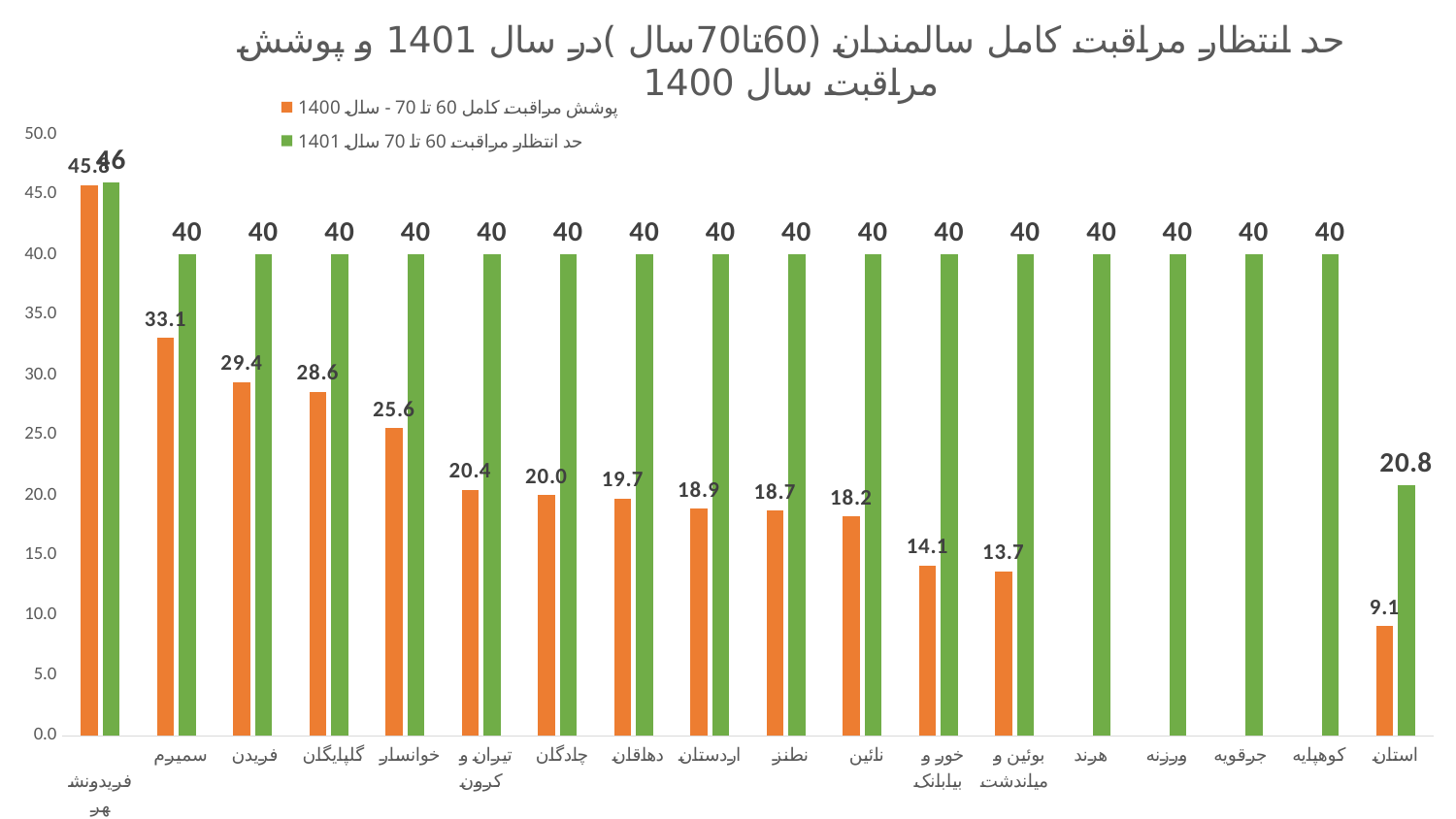
What is the value of the green series (حد انتظار مراقبت 60 تا 70 سال 1401) for استان? 20.8 What is the value of the green series (سال 1401) for فریدونشهر? 46 What is the value of the orange series (پوشش مراقبت کامل 60 تا 70 - سال 1400) for سمیرم? 33.1 How many categories are shown on the x axis? 18 Which category has the highest value in the orange series (سال 1400)? فریدونشهر What is the value of the orange series (سال 1400) for خور و بیابانک? 14.1 How many series does the legend list? 2 What kind of chart is shown on the slide? bar chart What is the difference between the orange (سال 1400) values for فریدن and گلپایگان? 0.8 Which category has the lowest value in the green series (سال 1401)? استان Is the orange (سال 1400) value for بوئین و میاندشت greater or less than 15.0? less Which is larger: the orange (سال 1400) value for خوانسار or for تیران و کرون? خوانسار